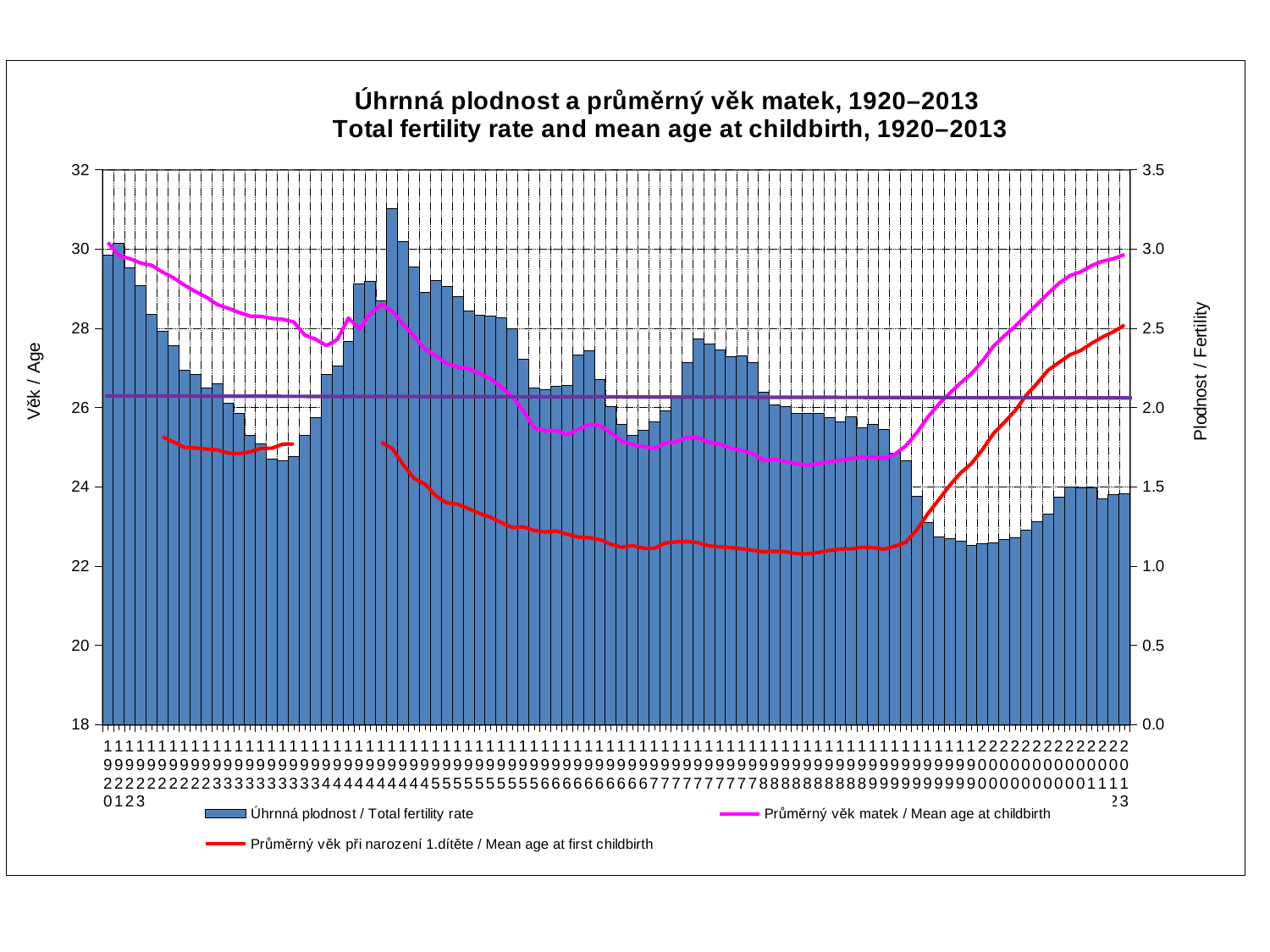
Does the mean age at childbirth rise or fall between 1990 and 2013? Rise What kind of chart is shown on the slide? A combined bar and line chart Does the total fertility rate rise or fall between 1920 and 1935? Fall Is the mean age at first childbirth in 2013 greater or less than 27? greater What colour are the bars for the total fertility rate? Blue How many series does the legend list? 3 Is the highest total fertility rate value shown by the bars greater or less than 3.0? greater Which is larger in 2013: the mean age at childbirth or the mean age at first childbirth? Mean age at childbirth What is the title of the chart in English? Total fertility rate and mean age at childbirth, 1920–2013 Is the mean age at childbirth in 2013 greater or less than 29? greater Which is larger: the total fertility rate in 1920 or in 2013? 1920